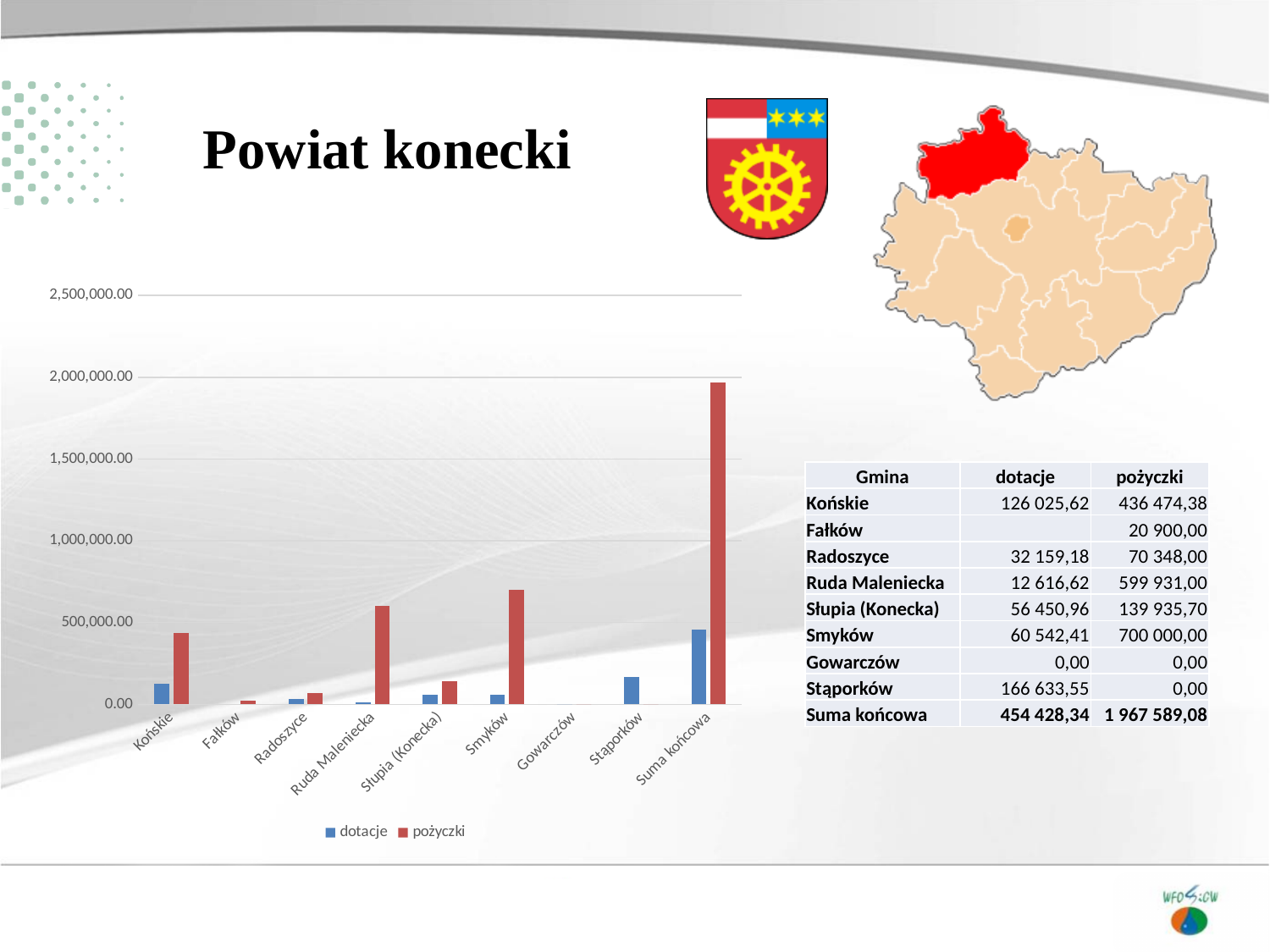
How many series does the chart legend list? 2 What is the pożyczki value for Ruda Maleniecka? 599 931,00 How many categories are shown on the x axis of the chart? 9 What is the dotacje value for Stąporków? 166 633,55 Which series is shown in red in the chart? pożyczki What is the difference between the pożyczki and dotacje values for Końskie? 310 448,76 Excluding Suma końcowa, which gmina has the highest pożyczki value? Smyków Excluding Suma końcowa, which gmina has the highest dotacje value? Stąporków Which is larger for Końskie, dotacje or pożyczki? pożyczki Is the pożyczki value for Suma końcowa greater or less than 1,500,000.00? greater What is the pożyczki value for Smyków? 700 000,00 What kind of chart is shown on the slide? bar chart